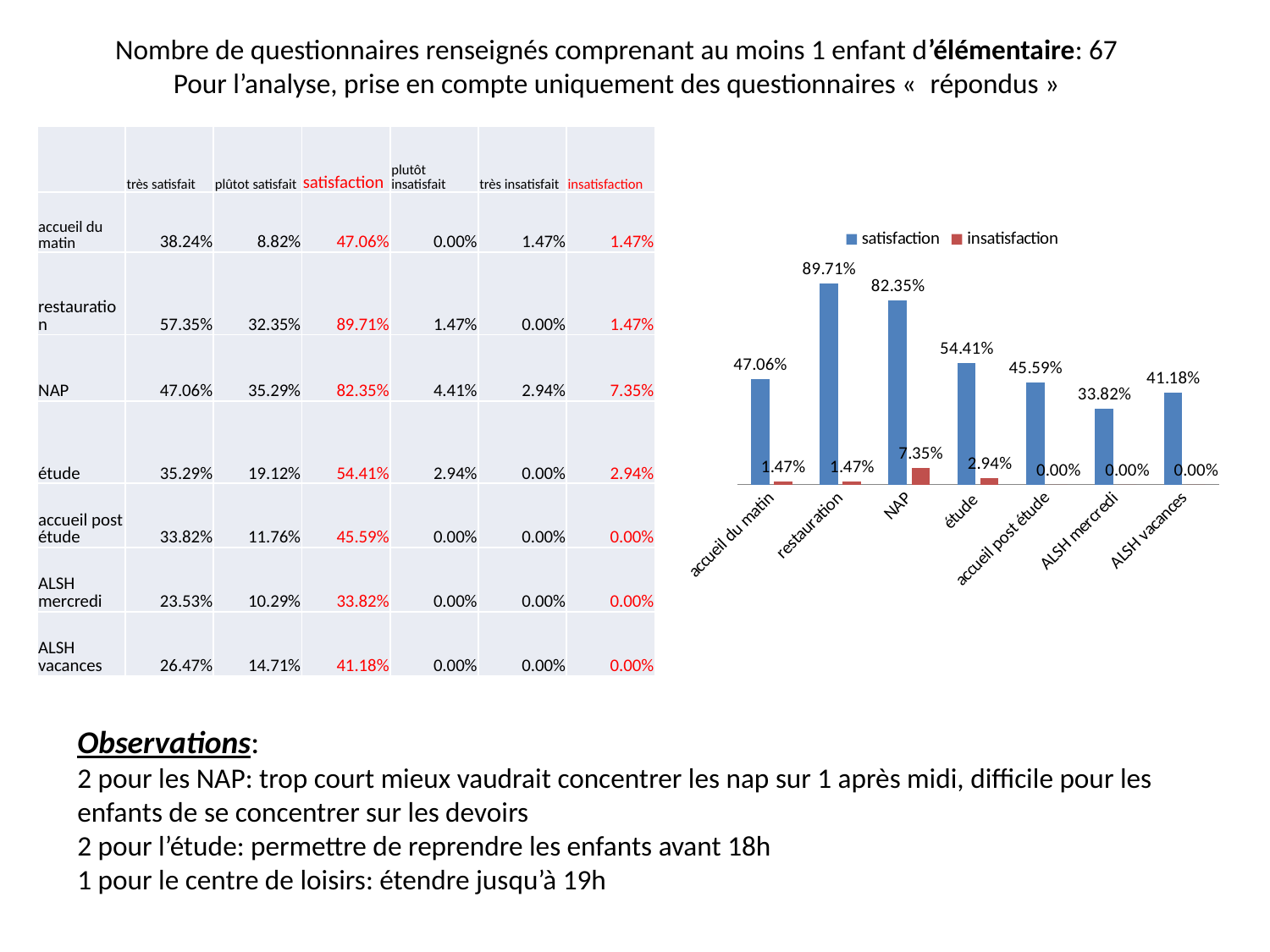
What is the satisfaction value for ALSH vacances? 41.18% Which category has the highest satisfaction value? restauration What is the difference between the satisfaction values for restauration and NAP? 7.36% Which category has the lowest satisfaction value? ALSH mercredi What is the satisfaction value for restauration? 89.71% Which category has the highest insatisfaction value? NAP What colour are the insatisfaction bars? red What kind of chart is shown on the slide? bar chart How many categories are shown on the x axis? 7 How many series does the legend list? 2 What is the insatisfaction value for NAP? 7.35% Which is larger, the satisfaction value for étude or for accueil post étude? étude